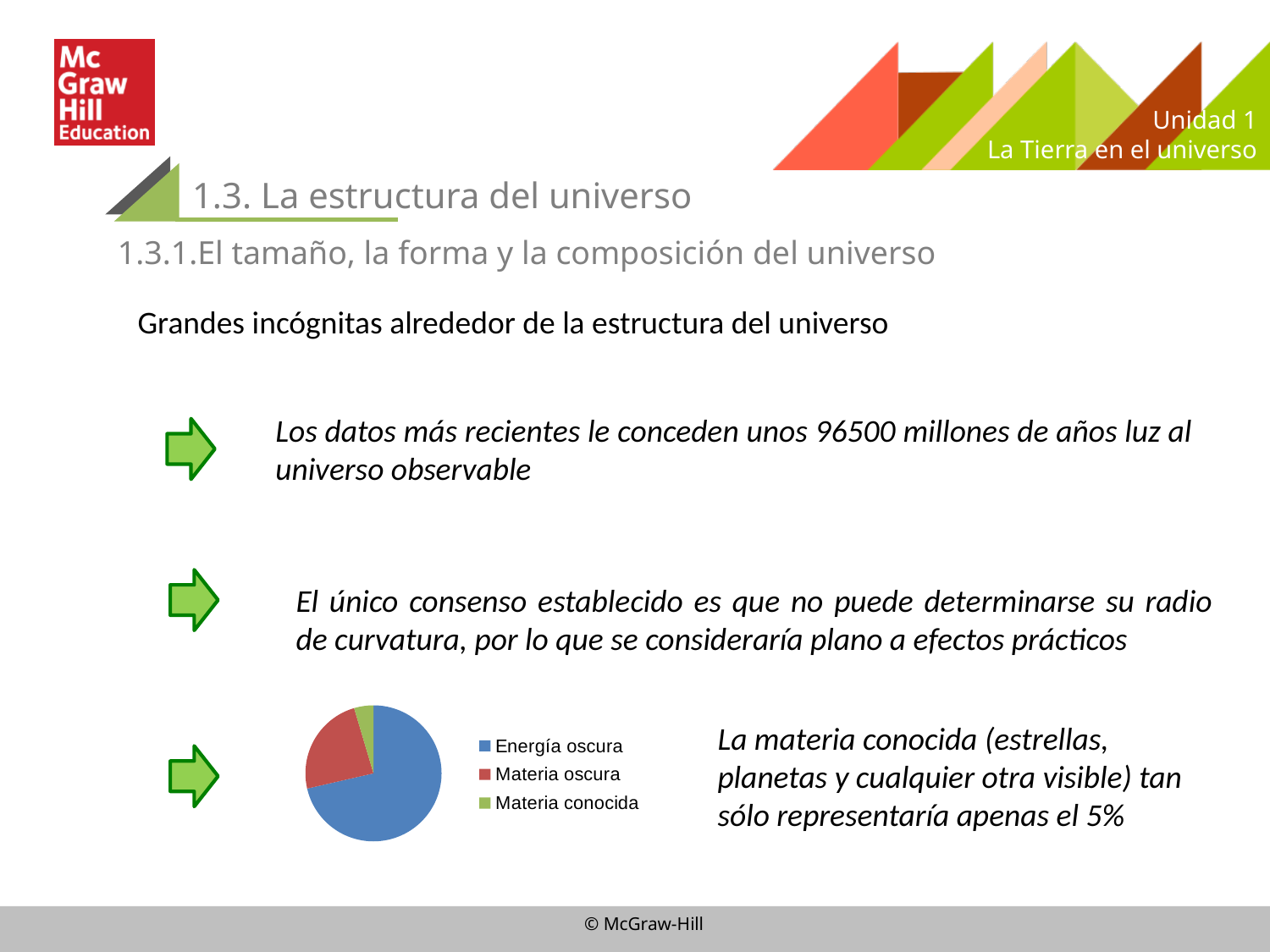
Which category is shown in green in the pie chart? Materia conocida How many entries does the legend of the pie chart list? 3 Which slice is larger in the pie chart, Materia oscura or Materia conocida? Materia oscura How many slices does the pie chart have? 3 Does the Energía oscura slice take up more or less than half of the pie chart? more What kind of chart is shown on the slide? pie chart Which slice is larger in the pie chart, Energía oscura or Materia oscura? Energía oscura What colour is the Materia oscura slice in the pie chart? red Which category has the largest slice in the pie chart? Energía oscura Which category has the smallest slice in the pie chart? Materia conocida